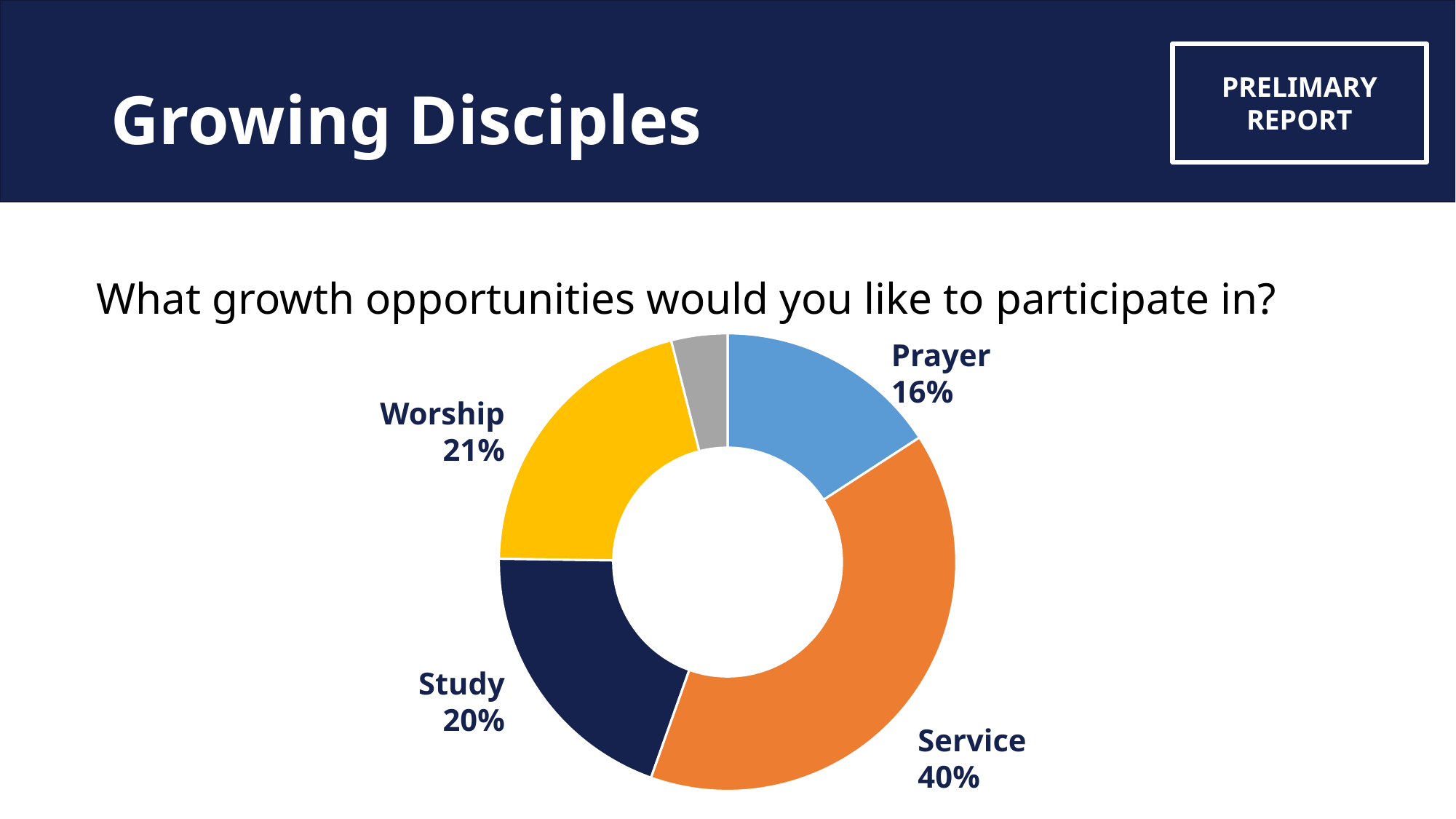
What percentage is labeled for Study? 20% How many percentage points larger is Service than Prayer? 24 What percentage of respondents chose Service? 40% Which is larger, Service or Worship? Service What question is written above the chart? What growth opportunities would you like to participate in? Which is larger, the share for Worship or the share for Study? Worship How many categories are labeled with a name and percentage on the chart? 4 Among the labeled categories, which has the smallest share? Prayer What is the value shown for Worship? 21% Which category has the largest share of the chart? Service What share does the Prayer slice show? 16% What kind of chart is shown on the slide? Doughnut chart